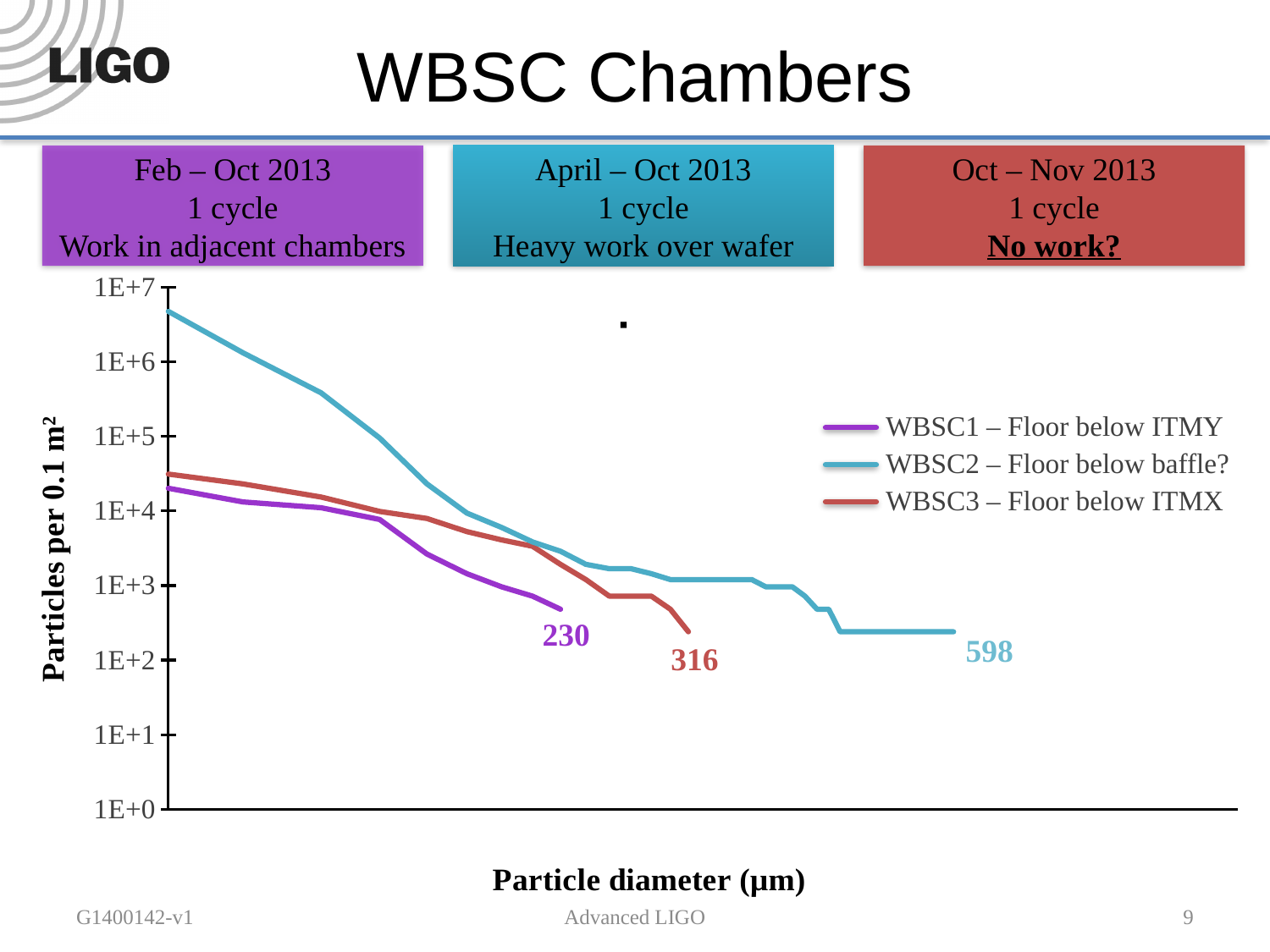
Is the final value of the WBSC2 – Floor below baffle? line greater or less than 1E+3? less Is the starting value of the WBSC1 – Floor below ITMY line greater or less than 1E+5? less What is the x-axis title of the chart? Particle diameter (µm) What kind of chart is shown on the slide? line chart Which series has the highest value at the left edge of the chart? WBSC2 – Floor below baffle? What number is printed at the end of the WBSC3 – Floor below ITMX line? 316 How many series does the legend list? 3 Do the values of each series rise or fall as particle diameter increases along the x axis? fall What number is printed at the end of the WBSC1 – Floor below ITMY line? 230 Which series extends furthest to the right along the x axis? WBSC2 – Floor below baffle? Is the starting value of the WBSC2 – Floor below baffle? line greater or less than 1E+6? greater Which series is plotted with the teal (light blue) line? WBSC2 – Floor below baffle?